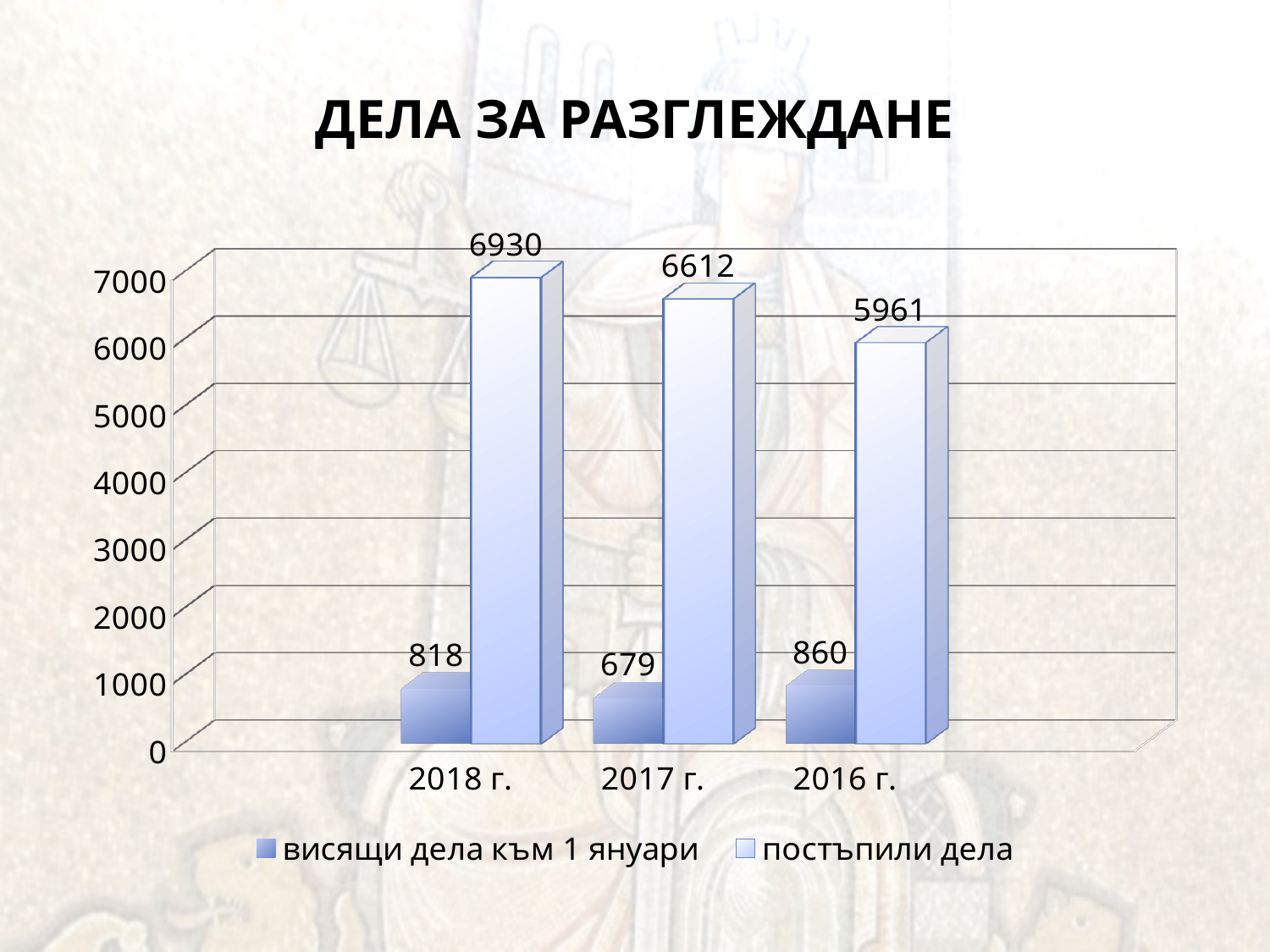
Which year has the highest value for "постъпили дела"? 2018 г. Which is larger: "постъпили дела" in 2017 г. or in 2016 г.? 2017 г. How many years are shown on the x axis? 3 How many series does the legend list? 2 What is the difference between "висящи дела към 1 януари" in 2016 г. and 2018 г.? 42 Is the value for "постъпили дела" in 2016 г. greater or less than 6000? less What kind of chart is shown on the slide? bar chart What is the value of "висящи дела към 1 януари" for 2017 г.? 679 Which year has the lowest value for "висящи дела към 1 януари"? 2017 г. What is the difference between "постъпили дела" in 2018 г. and 2017 г.? 318 What is the value of "висящи дела към 1 януари" for 2016 г.? 860 What is the value of "постъпили дела" for 2018 г.? 6930